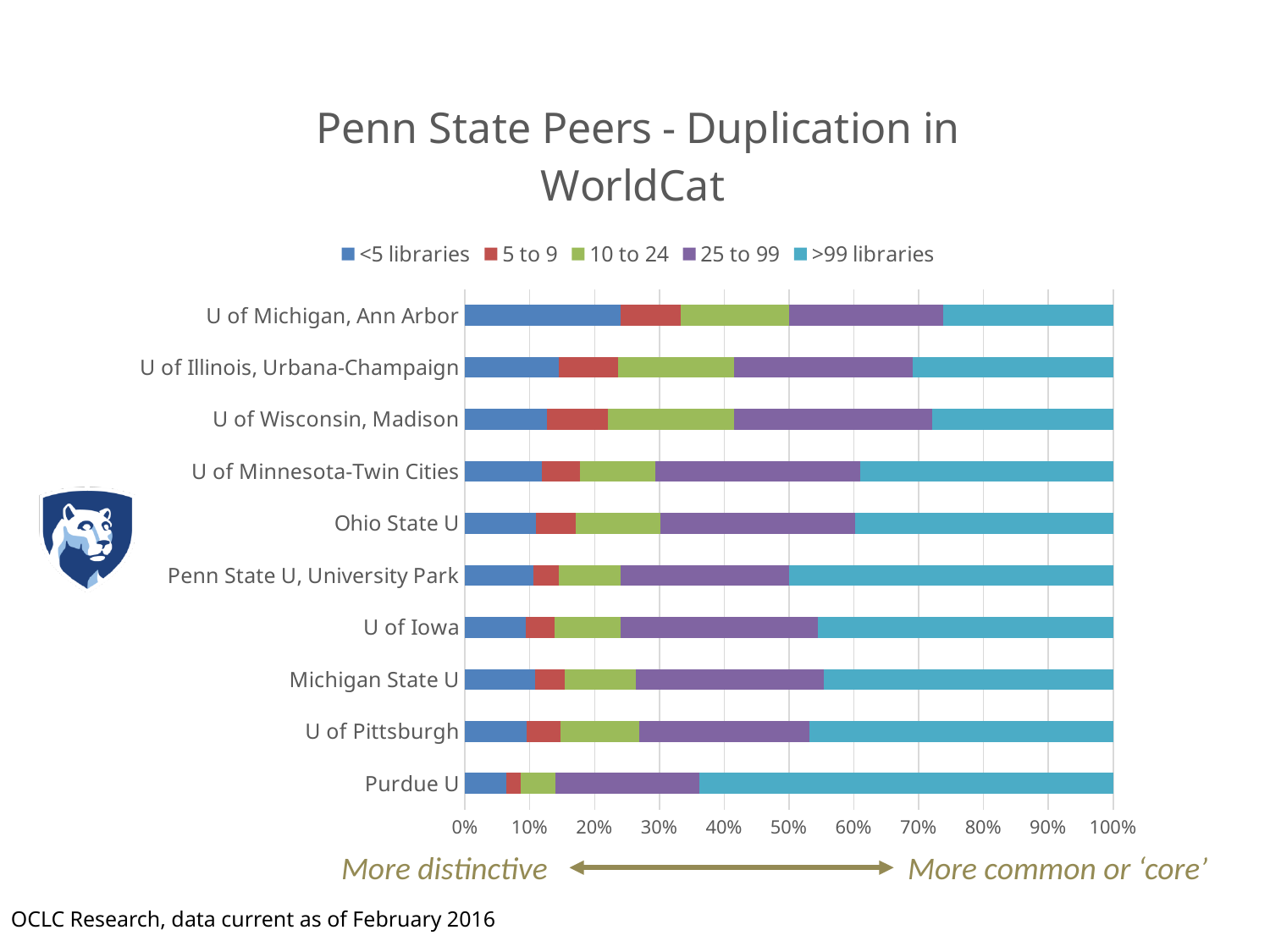
Which has the larger '>99 libraries' segment, Penn State U, University Park or Ohio State U? Penn State U, University Park Which university has the largest '<5 libraries' segment? U of Michigan, Ann Arbor Which university has the smallest '>99 libraries' segment? U of Michigan, Ann Arbor Is the '<5 libraries' value for U of Michigan, Ann Arbor greater or less than 20%? greater Is the '<5 libraries' value for Purdue U greater or less than 10%? less What kind of chart is shown on the slide? Stacked bar chart How many universities are listed on the chart? 10 Which university has the largest '>99 libraries' segment? Purdue U Which legend entry is shown in dark blue, first in the legend? <5 libraries Which university has the smallest '<5 libraries' segment? Purdue U How many series does the legend list? 5 What is the title of the chart? Penn State Peers - Duplication in WorldCat